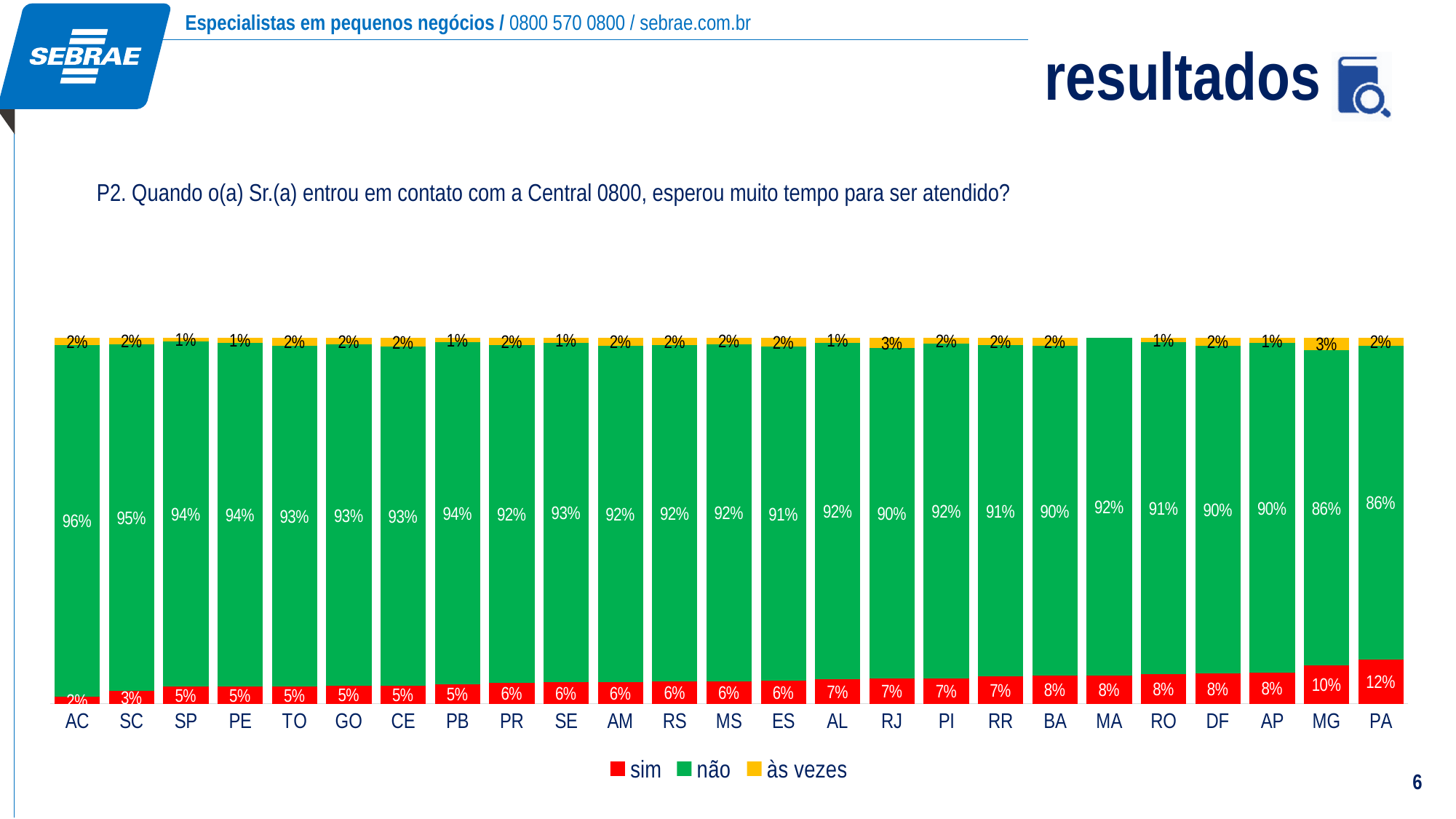
Which state has the highest "sim" percentage? PA How many series does the legend list? 3 What is the "às vezes" value for RJ? 3% What percentage of respondents in PA answered "sim"? 12% What is the total of the stacked bar for AC? 100% How many states are shown on the x axis? 25 Which state has the highest "não" percentage? AC What is the "não" value for AC? 96% What is the difference between the "sim" values for PA and MG? 2% What kind of chart is shown on the slide? Stacked bar chart Which is larger, the "não" value for SC or the "não" value for MG? SC Which state has the lowest "sim" percentage? AC